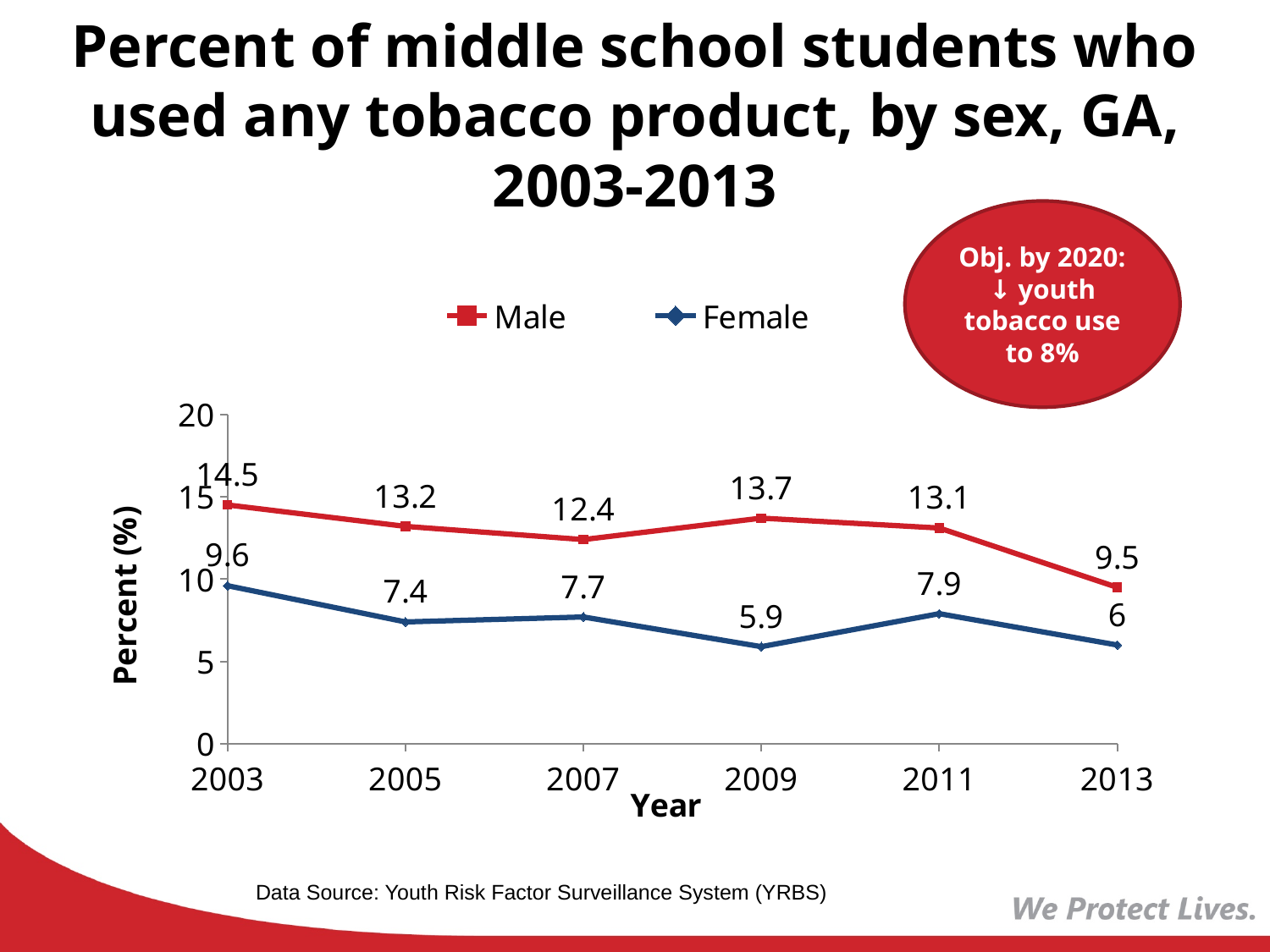
How many years are plotted on the x axis? 6 In which year was the Female series at its lowest value? 2009 What kind of chart is shown on the slide? Line chart What colour is the line for the Female series? Blue What was the percent of male middle school students who used any tobacco product in 2013? 9.5 What is the difference between the Male and Female values in 2007? 4.7 Did the Male series rise or fall overall from 2003 to 2013? Fall What was the percent of female middle school students who used any tobacco product in 2009? 5.9 What was the percent of male middle school students who used any tobacco product in 2003? 14.5 In which year was the Male series at its highest value? 2003 Which series had the higher value in 2011, Male or Female? Male How many series does the legend list? 2